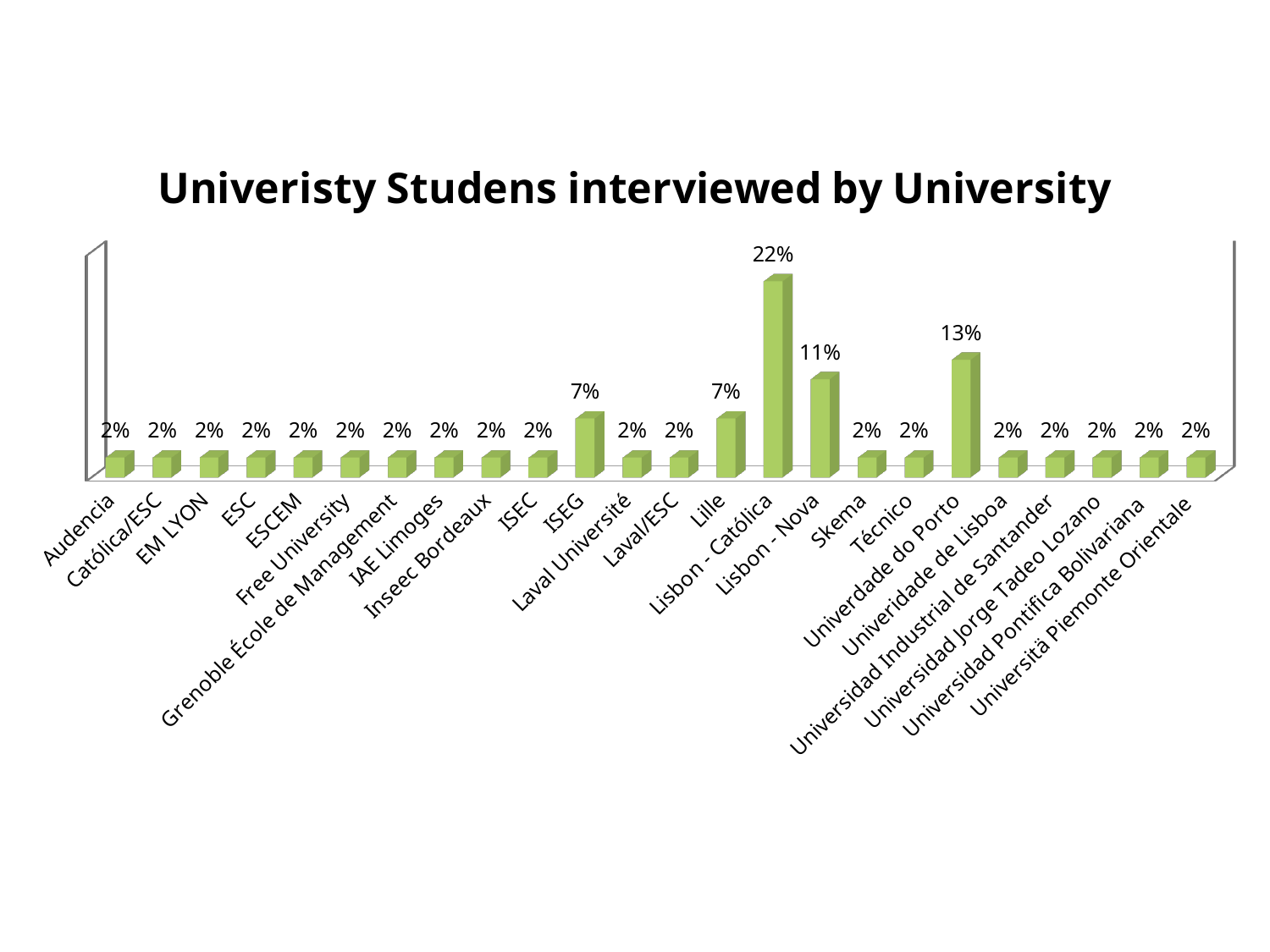
What percentage of students interviewed were from Lisbon - Nova? 11% Which university has the highest share of students interviewed? Lisbon - Católica What percentage of students interviewed were from Lisbon - Católica? 22% What is the difference between the shares for Lisbon - Católica and Univerdade do Porto? 9% What kind of chart is shown on the slide? Bar chart What is the difference between the shares for Lisbon - Nova and Lille? 4% What percentage of students interviewed were from ISEG? 7% What percentage of students interviewed were from Skema? 2% What percentage of students interviewed were from Univerdade do Porto? 13% Which is larger, the share for Univerdade do Porto or the share for Lisbon - Nova? Univerdade do Porto How many universities are shown on the chart? 24 What is the title of the chart? Univeristy Studens interviewed by University